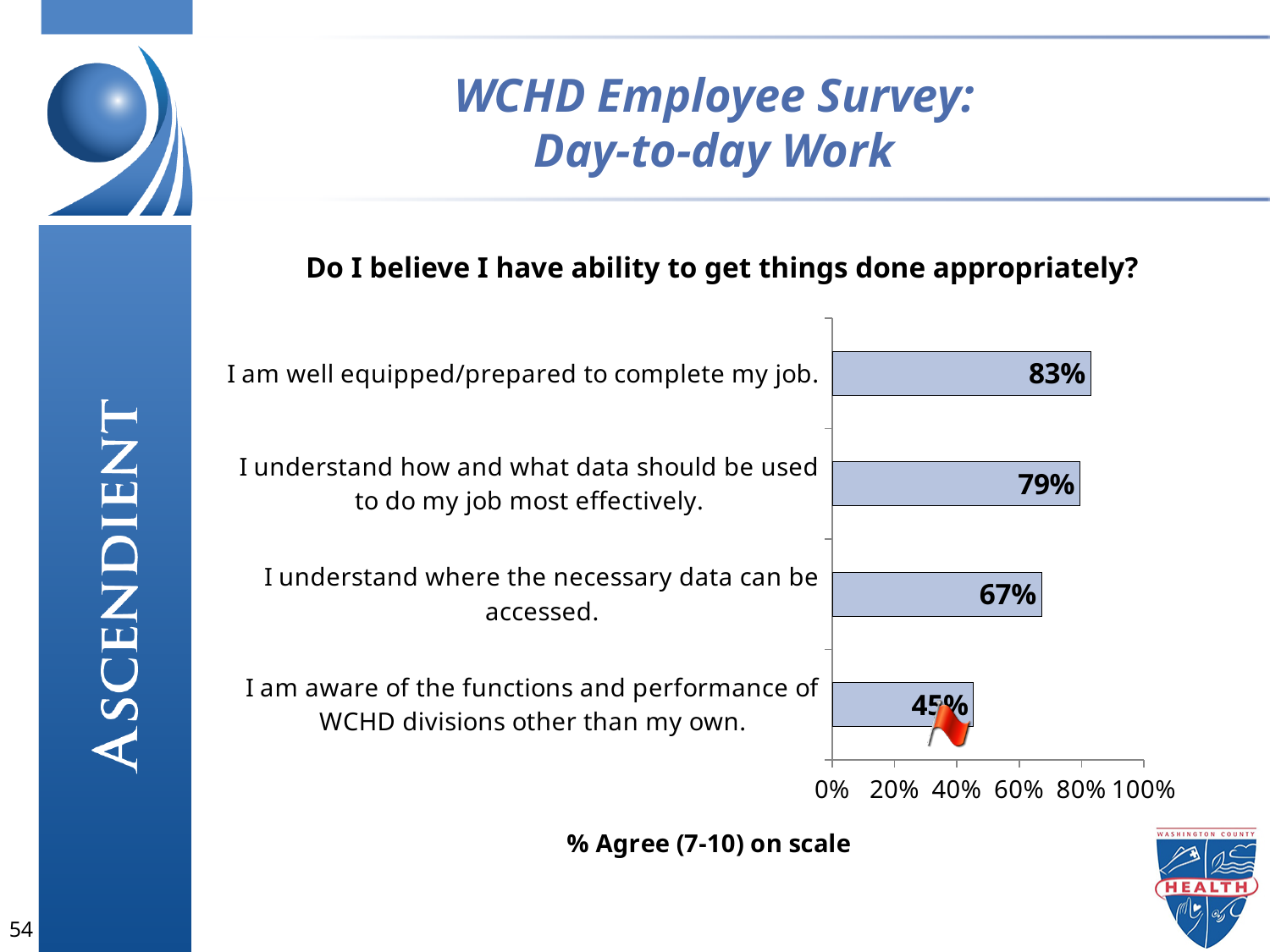
What kind of chart is shown on the slide? Bar chart What percentage of employees agree with "I am well equipped/prepared to complete my job."? 83% Which statement has the lowest percentage of agreement? I am aware of the functions and performance of WCHD divisions other than my own. What is the difference in agreement between "I am well equipped/prepared to complete my job." and "I am aware of the functions and performance of WCHD divisions other than my own."? 38% What is the difference in agreement between "I understand how and what data should be used to do my job most effectively." and "I understand where the necessary data can be accessed."? 12% What percentage of employees agree with "I am aware of the functions and performance of WCHD divisions other than my own."? 45% What question does the chart address, as stated above it? Do I believe I have ability to get things done appropriately? What percentage of employees agree with "I understand how and what data should be used to do my job most effectively."? 79% How many statements are shown in the chart? 4 What percentage of employees agree with "I understand where the necessary data can be accessed."? 67% Which has a higher agreement percentage: "I understand where the necessary data can be accessed." or "I am aware of the functions and performance of WCHD divisions other than my own."? I understand where the necessary data can be accessed. Which statement has the highest percentage of agreement? I am well equipped/prepared to complete my job.